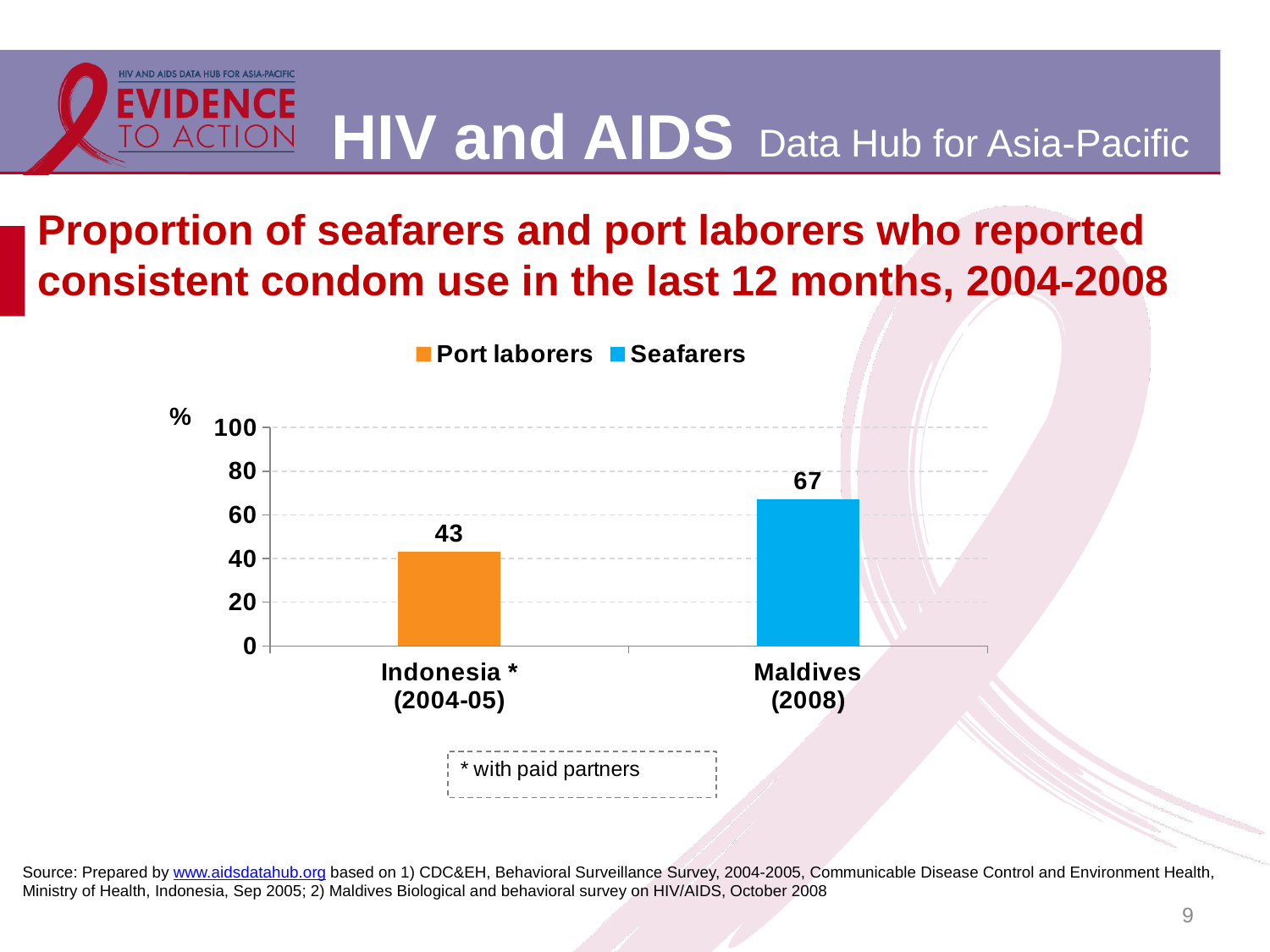
What is the difference between the values for Maldives (2008) and Indonesia (2004-05)? 24 Is the value for Indonesia (2004-05) greater or less than 60? less How many categories are shown on the x axis? 2 Which category has the highest value? Maldives (2008) Which series does the orange bar represent? Port laborers How many series does the legend list? 2 What is the value for Indonesia (2004-05)? 43 Which is larger, the value for Indonesia (2004-05) or the value for Maldives (2008)? Maldives (2008) Is the value for Maldives (2008) greater or less than 60? greater What kind of chart is shown on the slide? Bar chart Which category has the lowest value? Indonesia (2004-05) What is the value for Maldives (2008)? 67